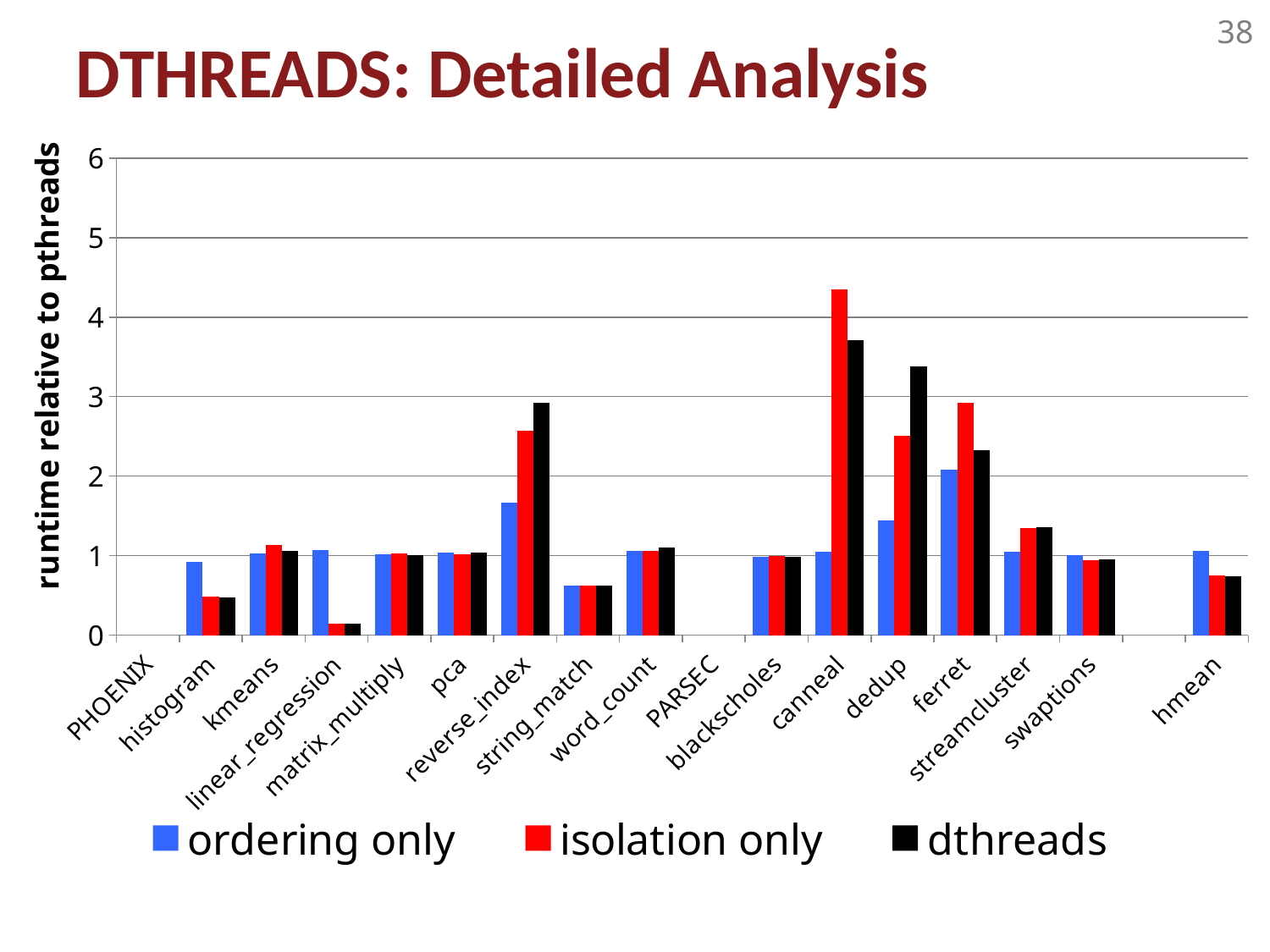
For ferret, which is larger: the 'isolation only' value or the 'dthreads' value? isolation only Which benchmark has the lowest 'ordering only' value? string_match Which benchmark has the highest 'dthreads' value? canneal Which benchmark has the highest 'isolation only' value? canneal How many series does the legend list? 3 Is the 'dthreads' value for histogram greater or less than 1? less For dedup, which is larger: the 'isolation only' value or the 'dthreads' value? dthreads What kind of chart is shown on the slide? bar chart What is the title of the y axis? runtime relative to pthreads Which benchmark has the lowest 'isolation only' value? linear_regression Is the 'dthreads' value for dedup greater or less than 3? greater Is the 'isolation only' value for canneal greater or less than 4? greater